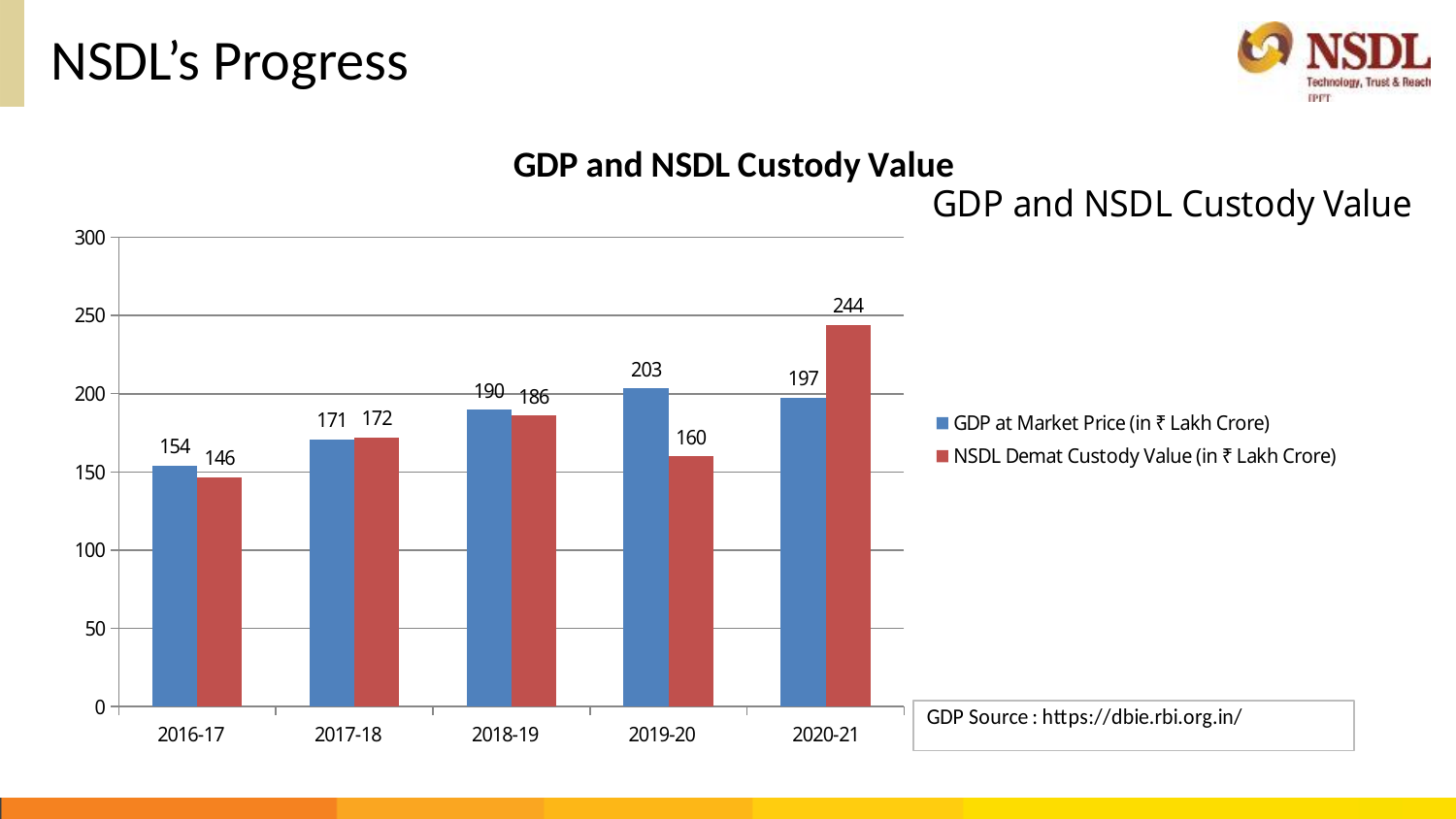
In which year is the GDP at Market Price lowest? 2016-17 How many years are shown on the x axis? 5 What is the NSDL Demat Custody Value for 2016-17? 146 What is the GDP at Market Price (in ₹ Lakh Crore) for 2019-20? 203 Which is larger in 2019-20: GDP at Market Price or NSDL Demat Custody Value? GDP at Market Price What is the title of the chart? GDP and NSDL Custody Value In which year is the NSDL Demat Custody Value highest? 2020-21 What kind of chart is shown on the slide? Bar chart What is the NSDL Demat Custody Value (in ₹ Lakh Crore) for 2020-21? 244 How many series does the legend list? 2 Is the GDP at Market Price for 2018-19 greater or less than 150? greater What is the difference between the NSDL Demat Custody Value and the GDP at Market Price in 2020-21? 47